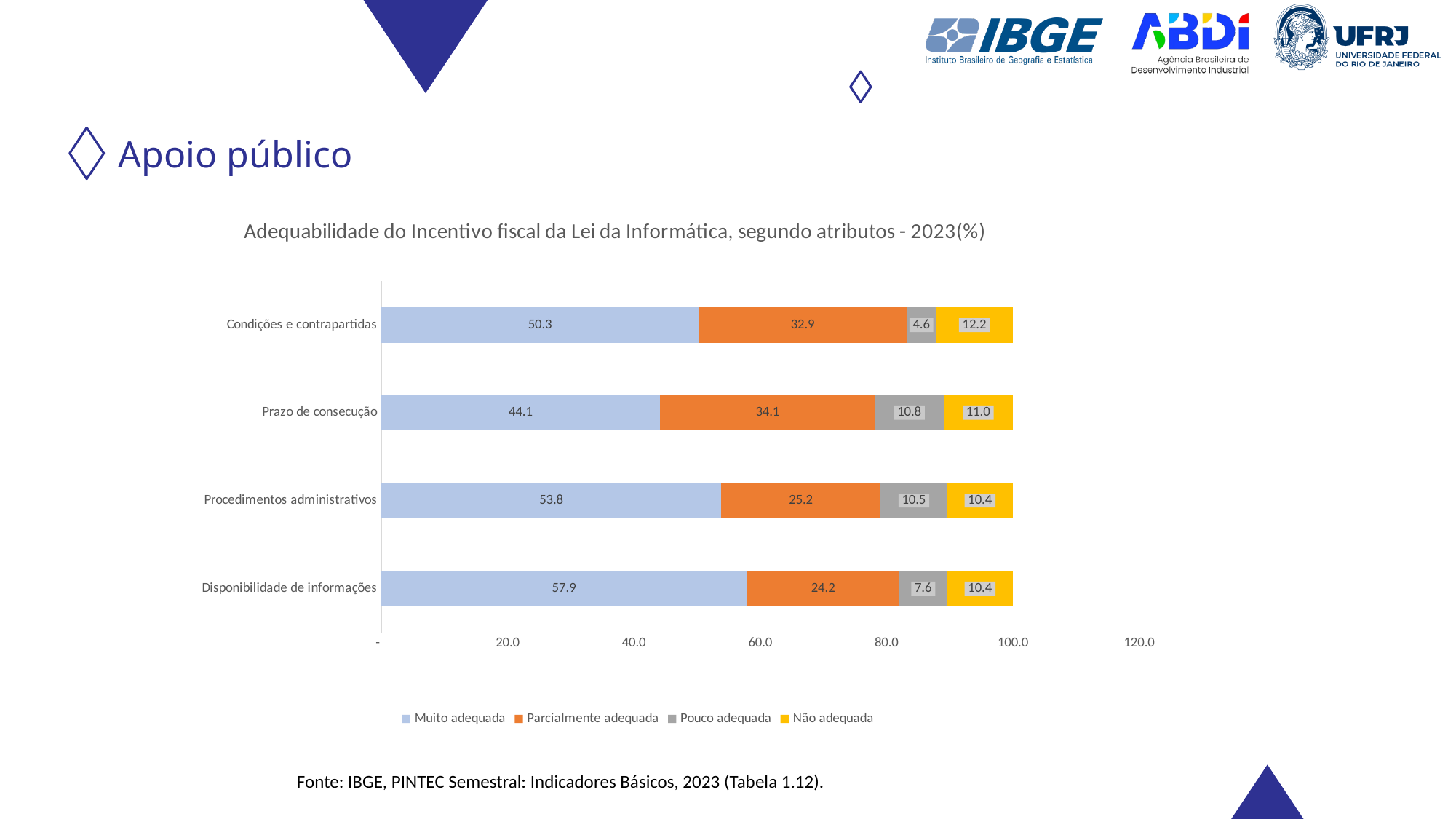
Which category has the lowest value for 'Pouco adequada'? Condições e contrapartidas What is the value of 'Não adequada' for 'Procedimentos administrativos'? 10.4 What type of chart is shown on the slide? Stacked bar chart How many series does the legend list? 4 What is the value of 'Muito adequada' for 'Disponibilidade de informações'? 57.9 What is the difference between the 'Muito adequada' values for 'Disponibilidade de informações' and 'Prazo de consecução'? 13.8 What is the value of 'Pouco adequada' for 'Condições e contrapartidas'? 4.6 Which category has the highest value for 'Muito adequada'? Disponibilidade de informações Which is larger: 'Parcialmente adequada' for 'Condições e contrapartidas' or for 'Procedimentos administrativos'? Condições e contrapartidas What is the value of 'Parcialmente adequada' for 'Prazo de consecução'? 34.1 What is the title of the chart? Adequabilidade do Incentivo fiscal da Lei da Informática, segundo atributos - 2023(%) How many categories are shown on the vertical axis? 4